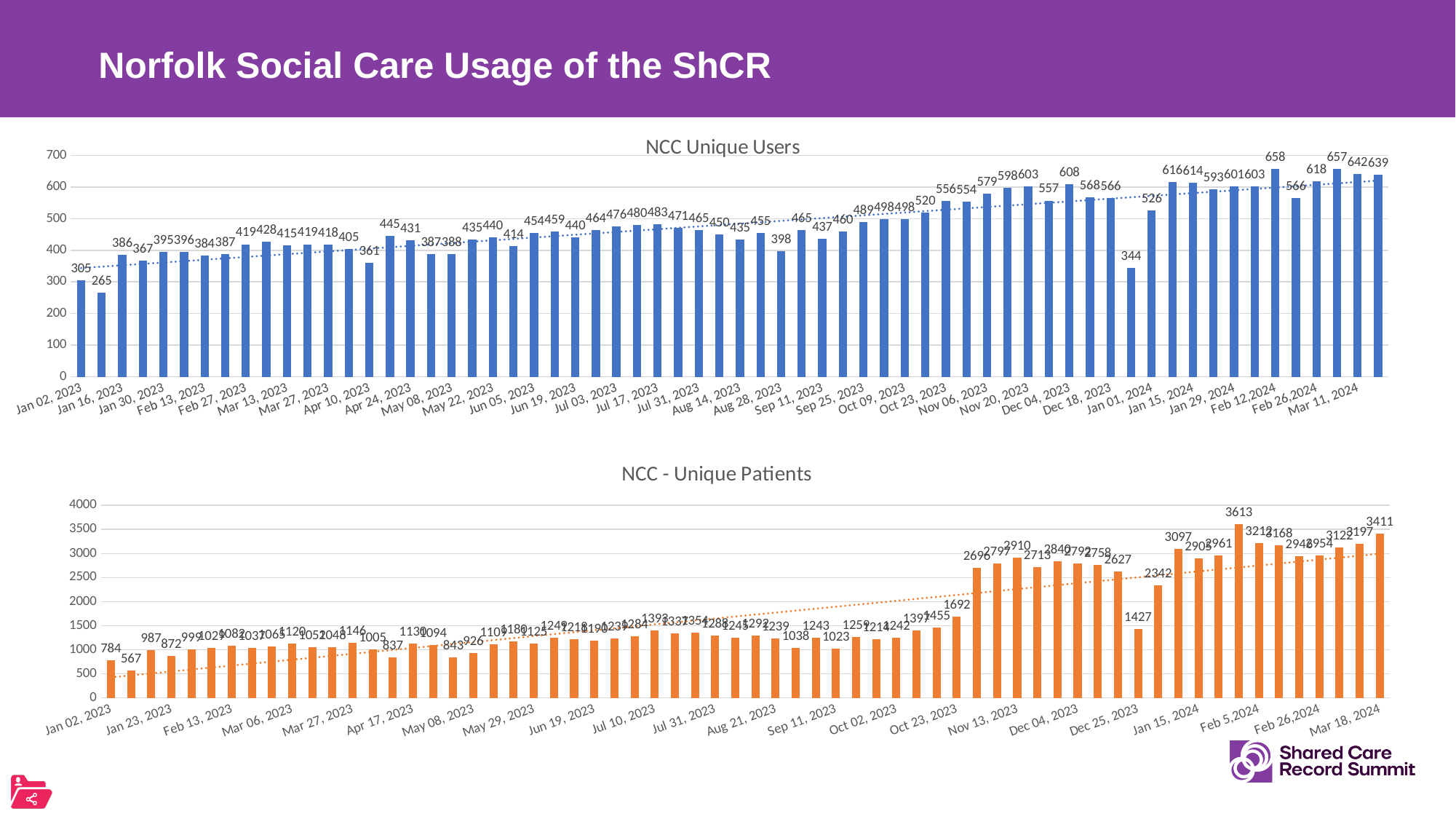
In the 'NCC - Unique Patients' chart, which is larger: the first bar (784) or the last bar (3411)? the last bar (3411) In the 'NCC - Unique Patients' chart, what is the lowest value shown? 567 In the 'NCC - Unique Patients' chart, what is the highest value shown? 3613 In the 'NCC Unique Users' chart, what is the value for the first bar, Jan 02, 2023? 305 In the 'NCC Unique Users' chart, what is the difference between the highest value (658) and the lowest value (265)? 393 In the 'NCC Unique Users' chart, do the values generally rise or fall from Jan 2023 to Mar 2024? rise What kind of chart is the 'NCC Unique Users' chart? bar chart In the 'NCC Unique Users' chart, what is the lowest value shown? 265 In the 'NCC - Unique Patients' chart, what is the value for the first bar, Jan 02, 2023? 784 In the 'NCC Unique Users' chart, what is the highest value shown? 658 What colour are the bars in the 'NCC - Unique Patients' chart? orange In the 'NCC - Unique Patients' chart, is the highest bar greater or less than 3500? greater